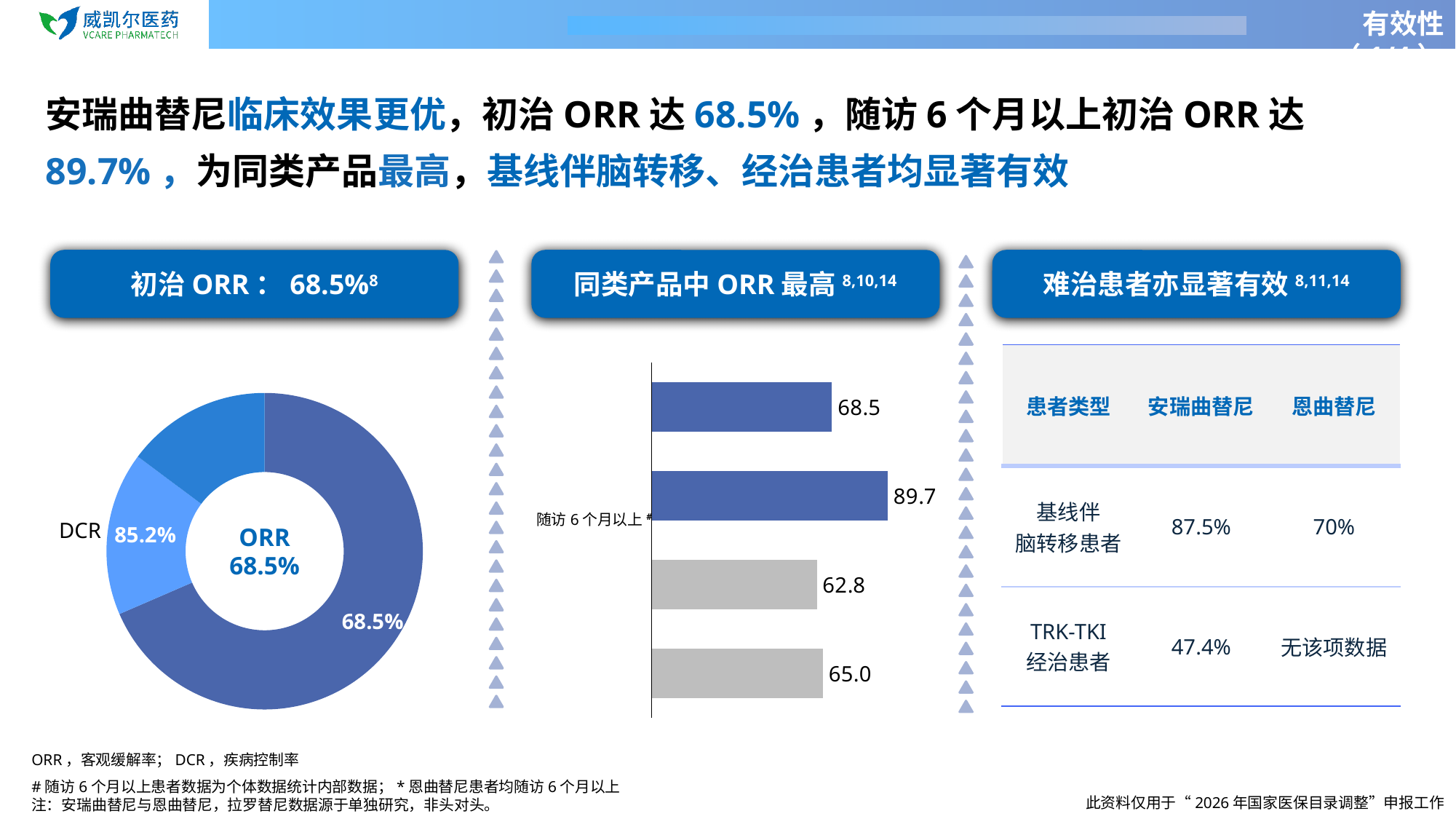
In the bar chart under "同类产品中 ORR 最高", what is the lowest value shown? 62.8 In the bar chart under "同类产品中 ORR 最高", what is the value of the bar labelled "随访 6 个月以上"? 89.7 In the donut chart under "初治 ORR： 68.5%", what value is shown for DCR? 85.2% In the bar chart under "同类产品中 ORR 最高", how many bars are plotted? 4 What kind of chart is shown under the heading "同类产品中 ORR 最高"? bar chart What kind of chart is shown under the heading "初治 ORR： 68.5%"? donut (pie) chart In the bar chart under "同类产品中 ORR 最高", what is the difference between the top bar (68.5) and the "随访 6 个月以上" bar (89.7)? 21.2 In the bar chart under "同类产品中 ORR 最高", how many bars are coloured grey? 2 In the bar chart under "同类产品中 ORR 最高", what is the highest value shown? 89.7 In the bar chart under "同类产品中 ORR 最高", which is larger: the top bar or the bottom bar? the top bar (68.5) In the bar chart under "同类产品中 ORR 最高", what is the difference between the two grey bars (65.0 and 62.8)? 2.2 In the donut chart under "初治 ORR： 68.5%", what value is shown for ORR? 68.5%